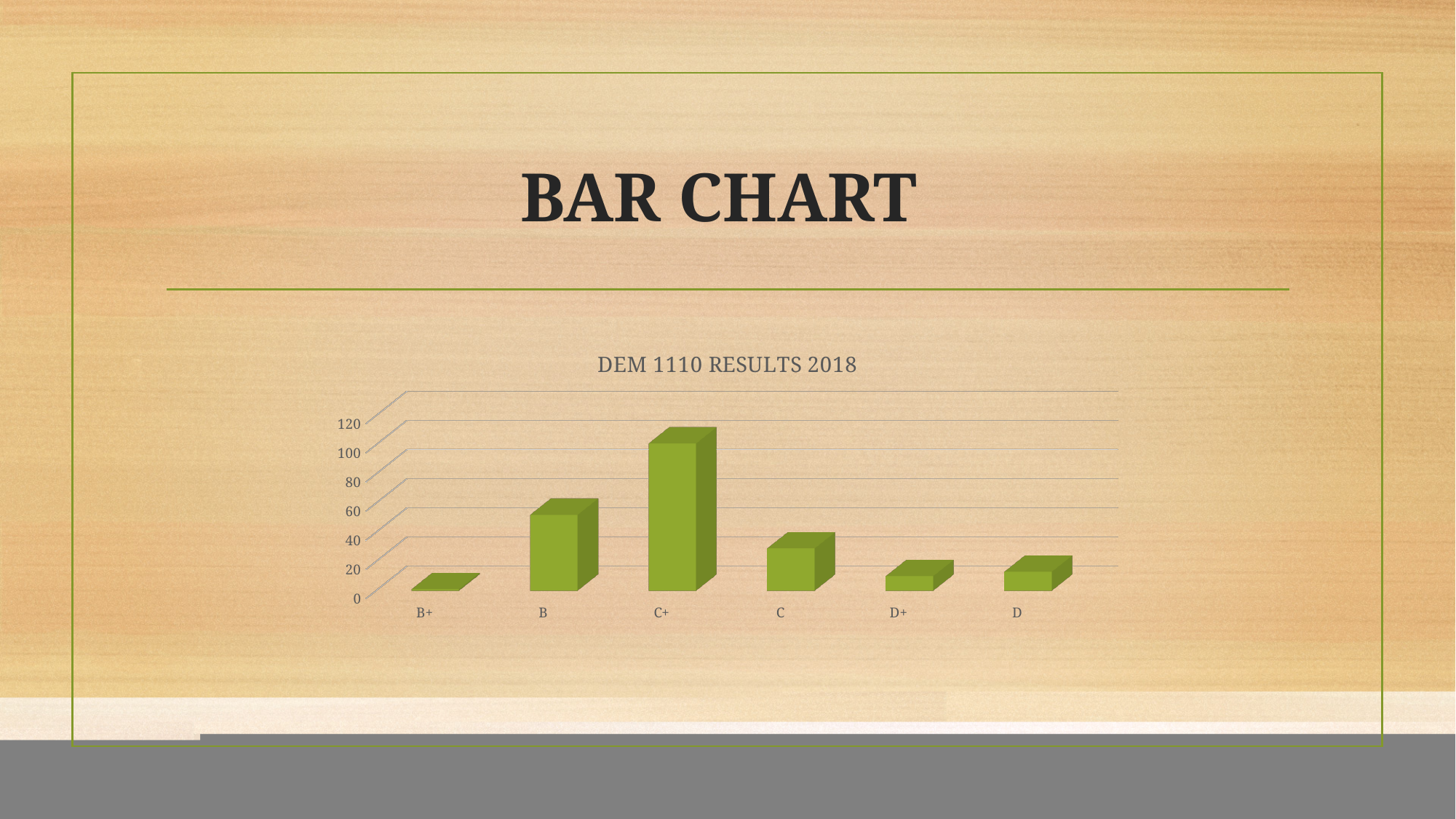
Do the values rise or fall along the x axis from C+ to D+? fall Is the value for B greater or less than 40? greater How many grade categories are shown on the x axis? 6 Is the value for C+ greater or less than 80? greater Which is larger, the value for B or the value for C? B What kind of chart is shown on the slide? bar chart Is the value for D+ greater or less than 20? less What is the title of the chart? DEM 1110 RESULTS 2018 Which grade has the lowest value? B+ Which grade has the highest value? C+